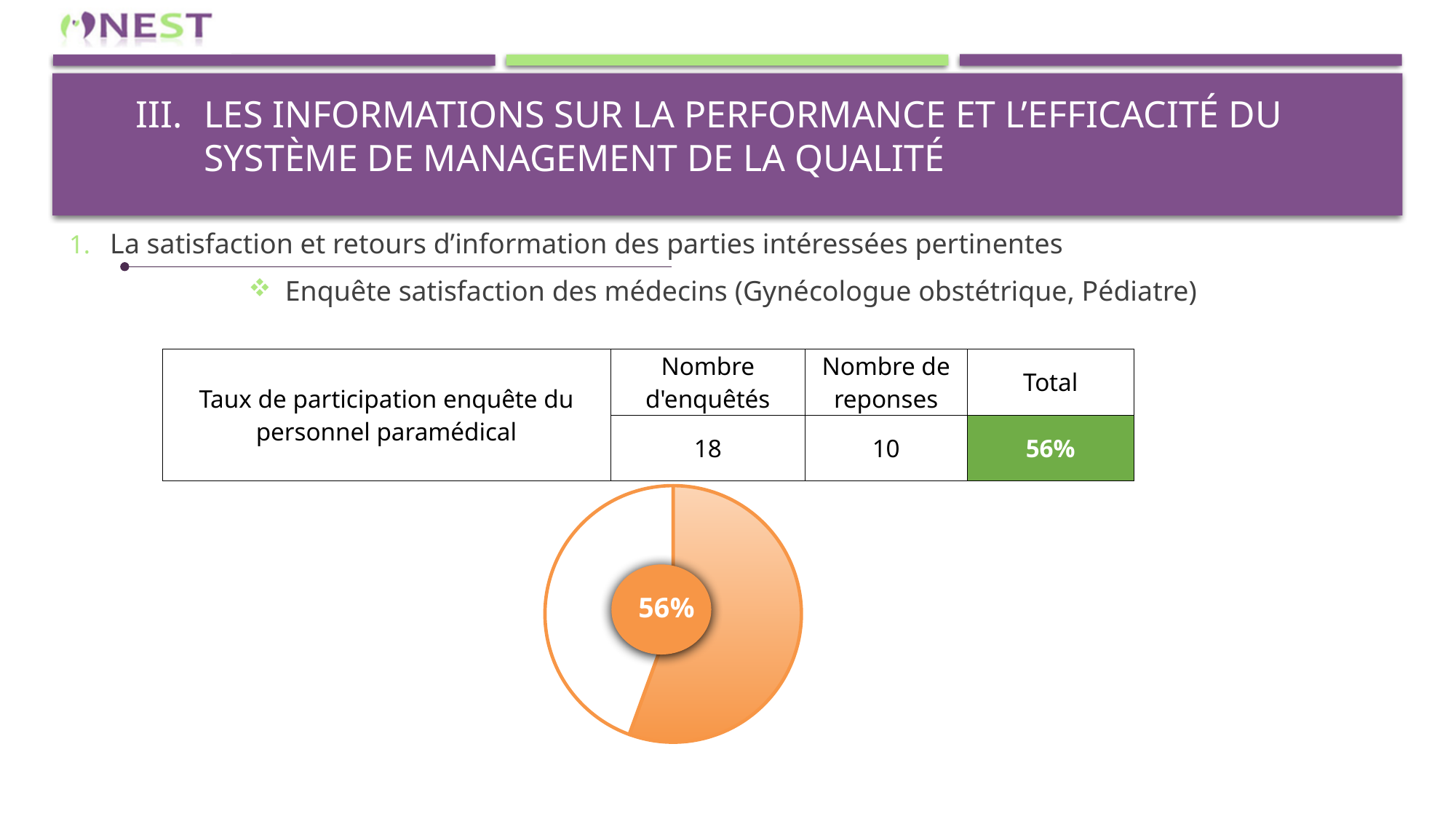
How many slices does the pie chart show? 2 Which slice of the pie chart is larger, the orange shaded slice or the white slice? the orange shaded slice What share of the pie does the orange (shaded) slice represent? 56% What value is printed on the data label of the pie chart? 56% Does the pie chart display a legend? No What colour is the slice of the pie chart that carries the 56% label? orange Is the share of the orange slice in the pie chart greater or less than 50%? greater What kind of chart is shown on the slide? pie chart